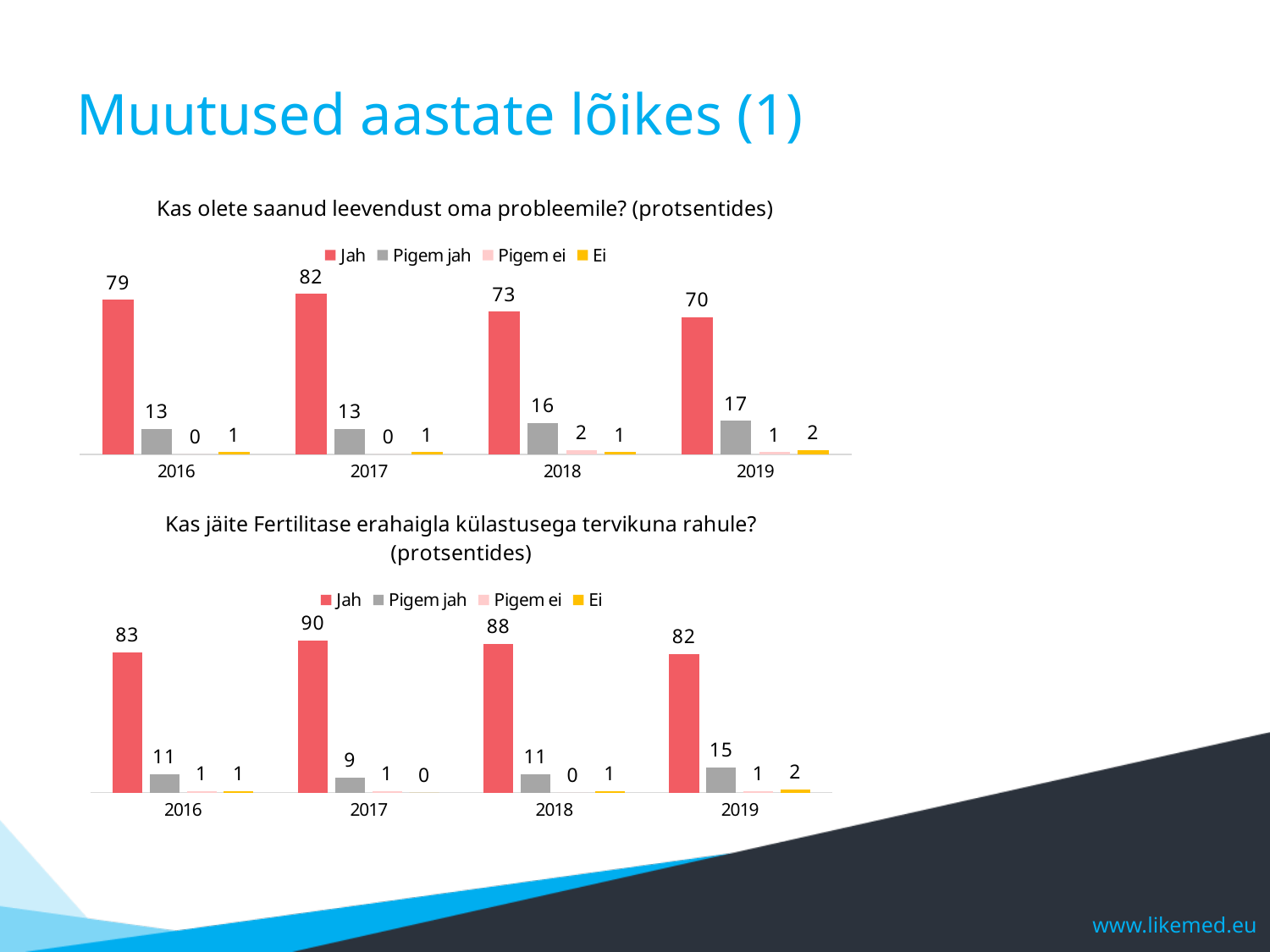
In the top chart 'Kas olete saanud leevendust oma probleemile?', what is the difference between the Jah values for 2016 and 2019? 9 In the top chart 'Kas olete saanud leevendust oma probleemile?', what is the value for Jah in 2017? 82 In the top chart 'Kas olete saanud leevendust oma probleemile?', which year has the highest Jah value? 2017 What kind of chart is the bottom chart 'Kas jäite Fertilitase erahaigla külastusega tervikuna rahule?'? bar chart In the bottom chart 'Kas jäite Fertilitase erahaigla külastusega tervikuna rahule?', is the Pigem jah value larger in 2019 or in 2017? 2019 In the bottom chart 'Kas jäite Fertilitase erahaigla külastusega tervikuna rahule?', what is the difference between the Jah values for 2017 and 2019? 8 In the top chart 'Kas olete saanud leevendust oma probleemile?', what is the value for Pigem jah in 2019? 17 In the top chart 'Kas olete saanud leevendust oma probleemile?', does the Jah value rise or fall from 2017 to 2019? fall In the bottom chart 'Kas jäite Fertilitase erahaigla külastusega tervikuna rahule?', which year has the highest Jah value? 2017 In the bottom chart 'Kas jäite Fertilitase erahaigla külastusega tervikuna rahule?', what is the value for Jah in 2018? 88 In the top chart 'Kas olete saanud leevendust oma probleemile?', which year has the lowest Jah value? 2019 How many series does the legend of the top chart list? 4